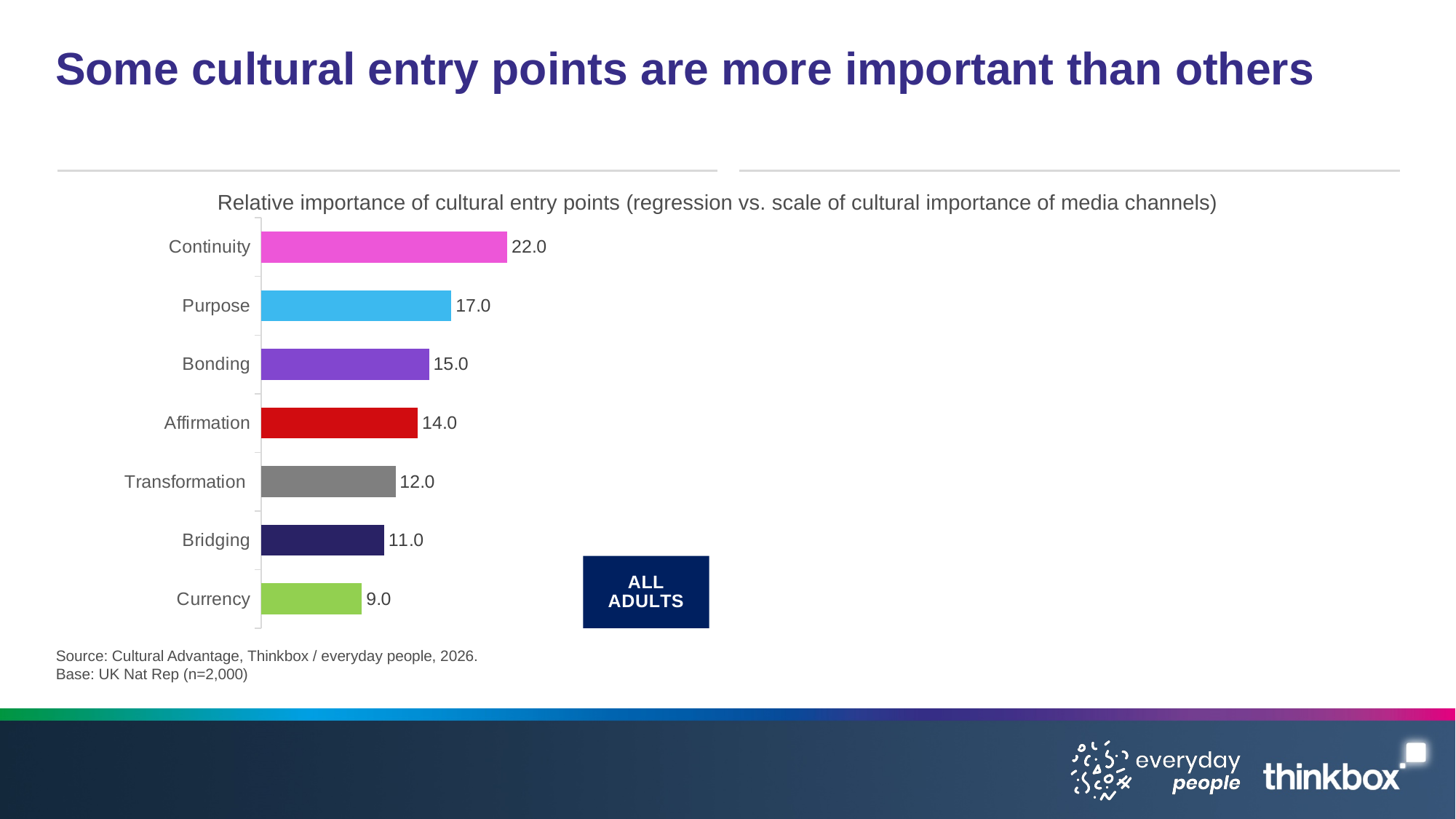
Which cultural entry point has the lowest value? Currency What is the difference between the values for Continuity and Purpose? 5.0 What is the value for Transformation? 12.0 Which is larger, the value for Affirmation or the value for Transformation? Affirmation How many cultural entry points are shown in the chart? 7 What kind of chart is shown on the slide? Bar chart What is the title of the chart? Relative importance of cultural entry points (regression vs. scale of cultural importance of media channels) What colour is the bar for Currency? Green What is the difference between the values for Bonding and Currency? 6.0 What is the value for Continuity? 22.0 What is the value for Bridging? 11.0 Which cultural entry point has the highest value? Continuity